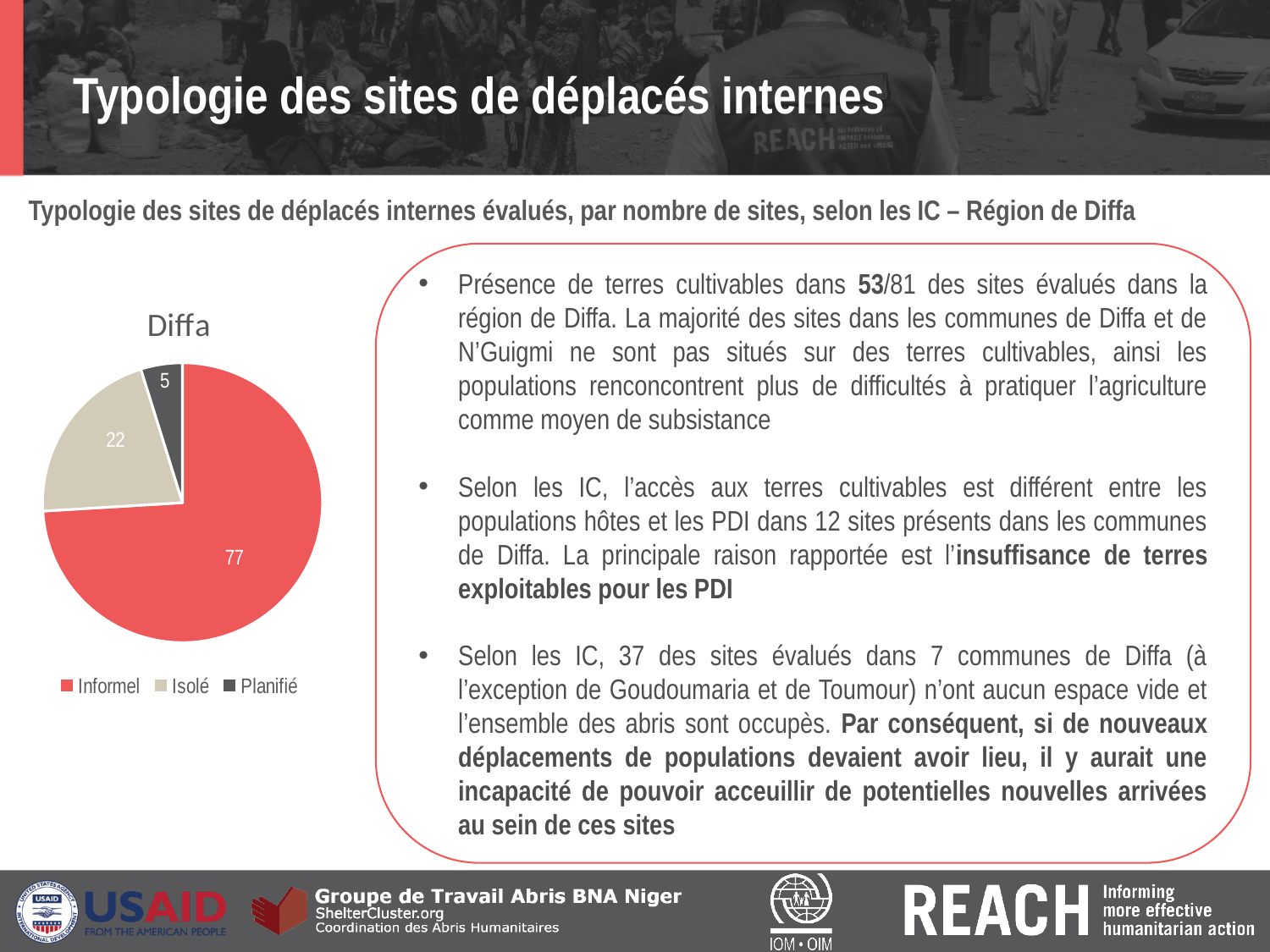
What is the difference between the values for Isolé and Planifié? 17 What is the difference between the values for Informel and Isolé? 55 What is the value for Planifié in the pie chart? 5 Which category has the smallest slice in the pie chart? Planifié Which category has the largest slice in the pie chart? Informel What is the value for Isolé in the pie chart? 22 How many categories does the pie chart show? 3 Which is larger, the value for Isolé or the value for Planifié? Isolé What kind of chart is shown on the slide? pie chart What is the title of the pie chart? Diffa What is the value for Informel in the pie chart? 77 What is the total of all slices in the pie chart? 104